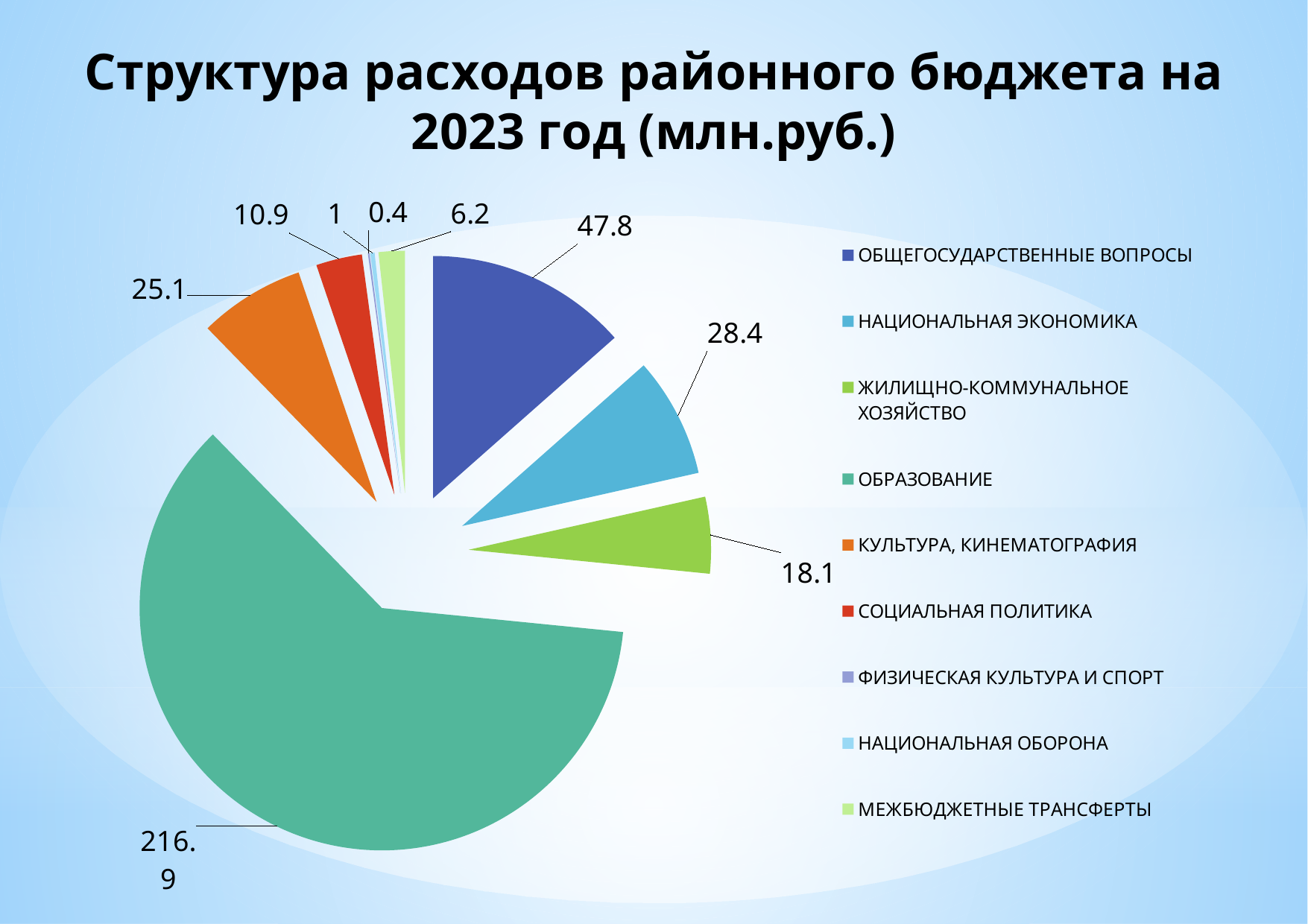
What is the value for ОБРАЗОВАНИЕ? 216.9 What is the value for НАЦИОНАЛЬНАЯ ЭКОНОМИКА? 28.4 Which category has the largest slice of the pie? ОБРАЗОВАНИЕ Which is larger, the value for СОЦИАЛЬНАЯ ПОЛИТИКА or the value for МЕЖБЮДЖЕТНЫЕ ТРАНСФЕРТЫ? СОЦИАЛЬНАЯ ПОЛИТИКА What is the title of the chart? Структура расходов районного бюджета на 2023 год (млн.руб.) What is the difference between the values for ОБЩЕГОСУДАРСТВЕННЫЕ ВОПРОСЫ and НАЦИОНАЛЬНАЯ ЭКОНОМИКА? 19.4 What is the value for КУЛЬТУРА, КИНЕМАТОГРАФИЯ? 25.1 What is the value for ОБЩЕГОСУДАРСТВЕННЫЕ ВОПРОСЫ? 47.8 What kind of chart is shown on the slide? pie chart Which category has the smallest slice of the pie? ФИЗИЧЕСКАЯ КУЛЬТУРА И СПОРТ What is the value for НАЦИОНАЛЬНАЯ ОБОРОНА? 1 How many categories does the legend list? 9